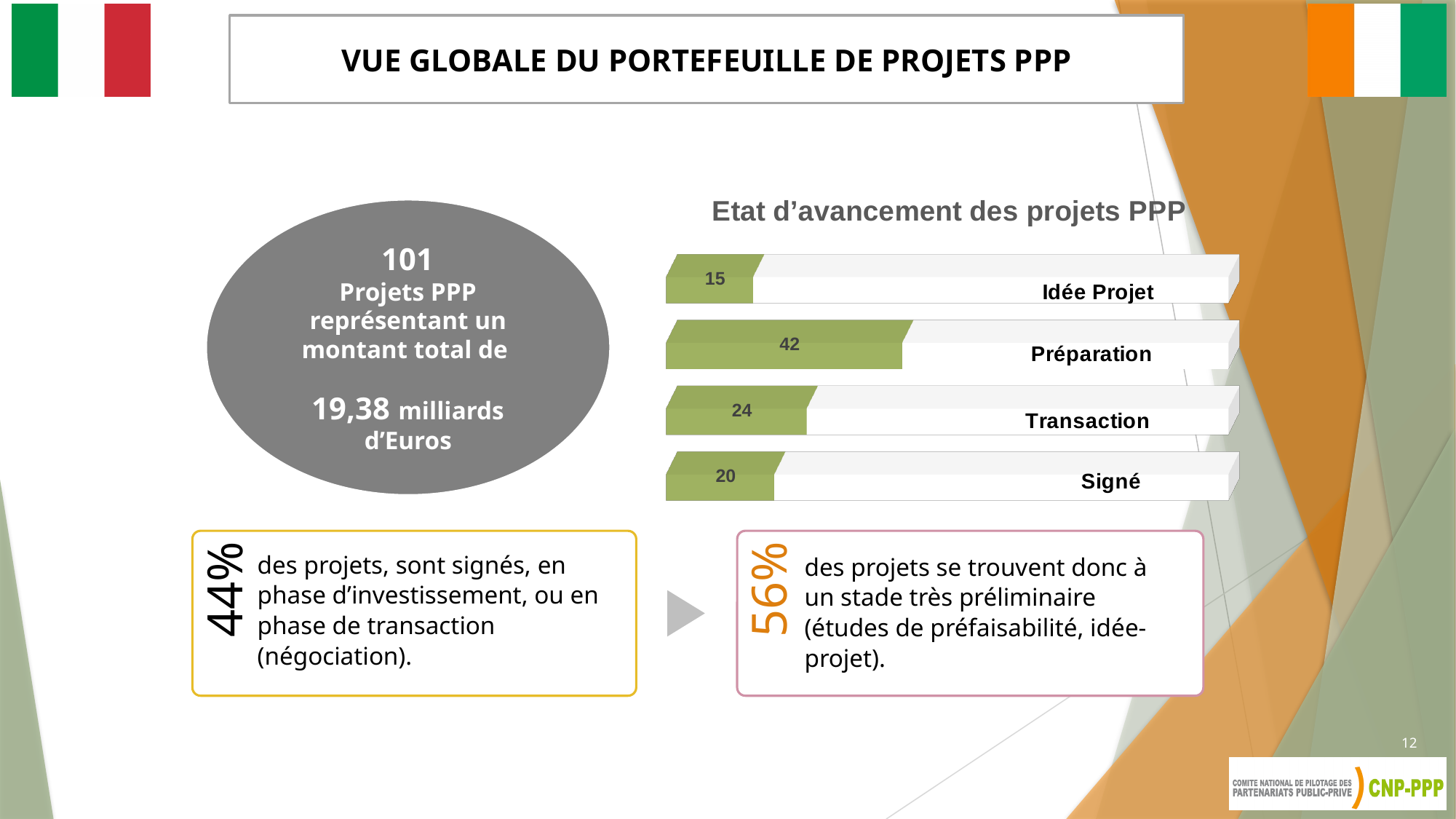
What is the value for Préparation in the chart 'Etat d'avancement des projets PPP'? 42 Which is larger in the chart 'Etat d'avancement des projets PPP': Transaction or Signé? Transaction What is the difference between the values for Préparation and Transaction in the chart 'Etat d'avancement des projets PPP'? 18 What is the value for Signé in the chart 'Etat d'avancement des projets PPP'? 20 What is the value for Idée Projet in the chart 'Etat d'avancement des projets PPP'? 15 What is the value for Transaction in the chart 'Etat d'avancement des projets PPP'? 24 Which category has the highest value in the chart 'Etat d'avancement des projets PPP'? Préparation How many categories are shown in the chart 'Etat d'avancement des projets PPP'? 4 What is the total of all four values in the chart 'Etat d'avancement des projets PPP'? 101 What is the title of the chart on the slide? Etat d'avancement des projets PPP Which category has the lowest value in the chart 'Etat d'avancement des projets PPP'? Idée Projet What kind of chart is 'Etat d'avancement des projets PPP'? Bar chart